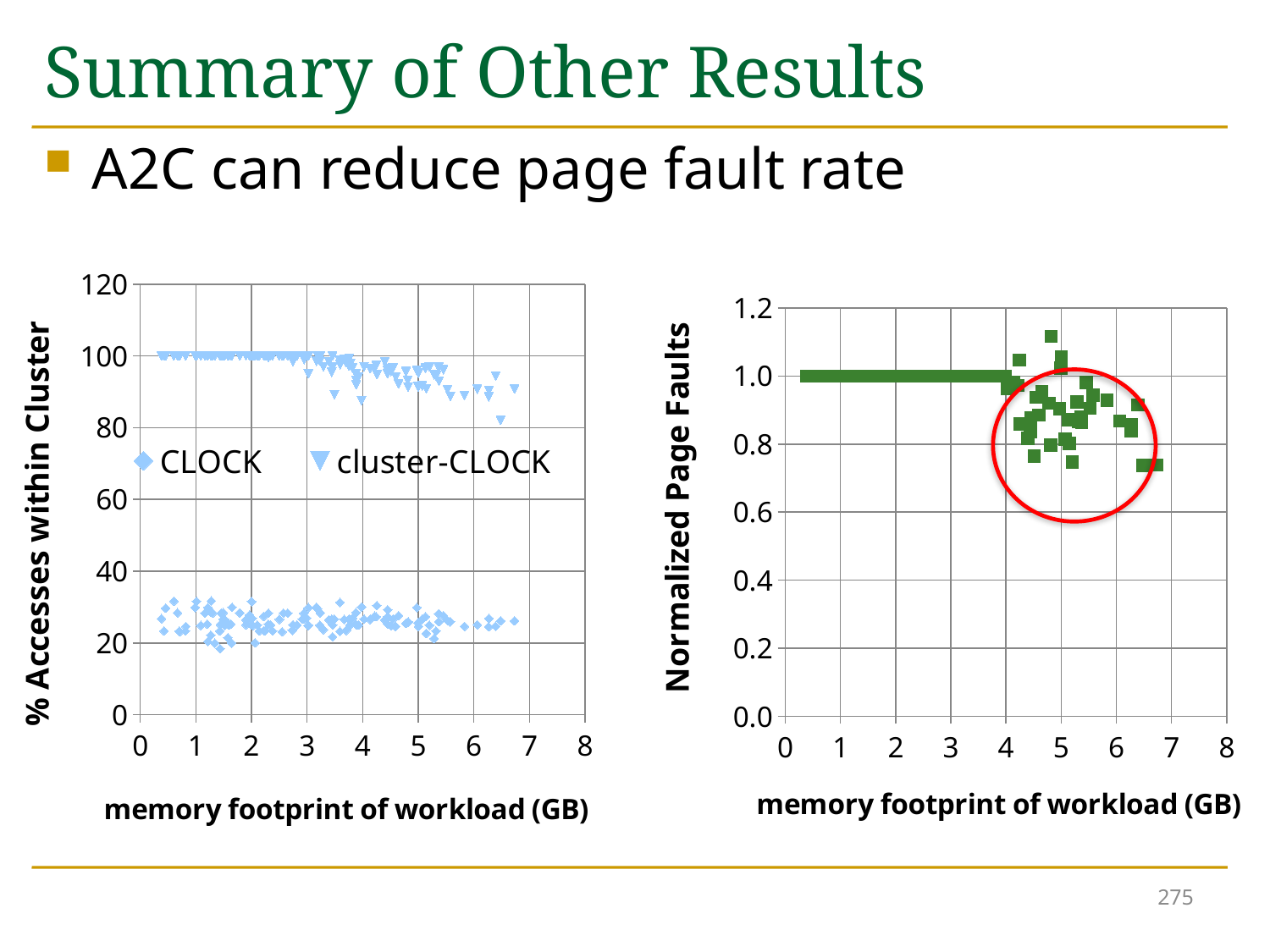
In the left chart, are the cluster-CLOCK values greater or less than 80? greater What kind of chart is the left chart on the slide? scatter chart What kind of chart is the right chart on the slide? scatter chart What is the y-axis label of the right chart? Normalized Page Faults In the left chart, which series has the higher values: CLOCK or cluster-CLOCK? cluster-CLOCK In the right chart, are the values for memory footprints below 4 GB greater or less than 1.2? less What is the y-axis label of the left chart? % Accesses within Cluster In the left chart, are the CLOCK values greater or less than 40? less How many series does the legend of the left chart list? 2 In the right chart, do the normalized page fault values rise or fall as the memory footprint increases beyond 4 GB? fall